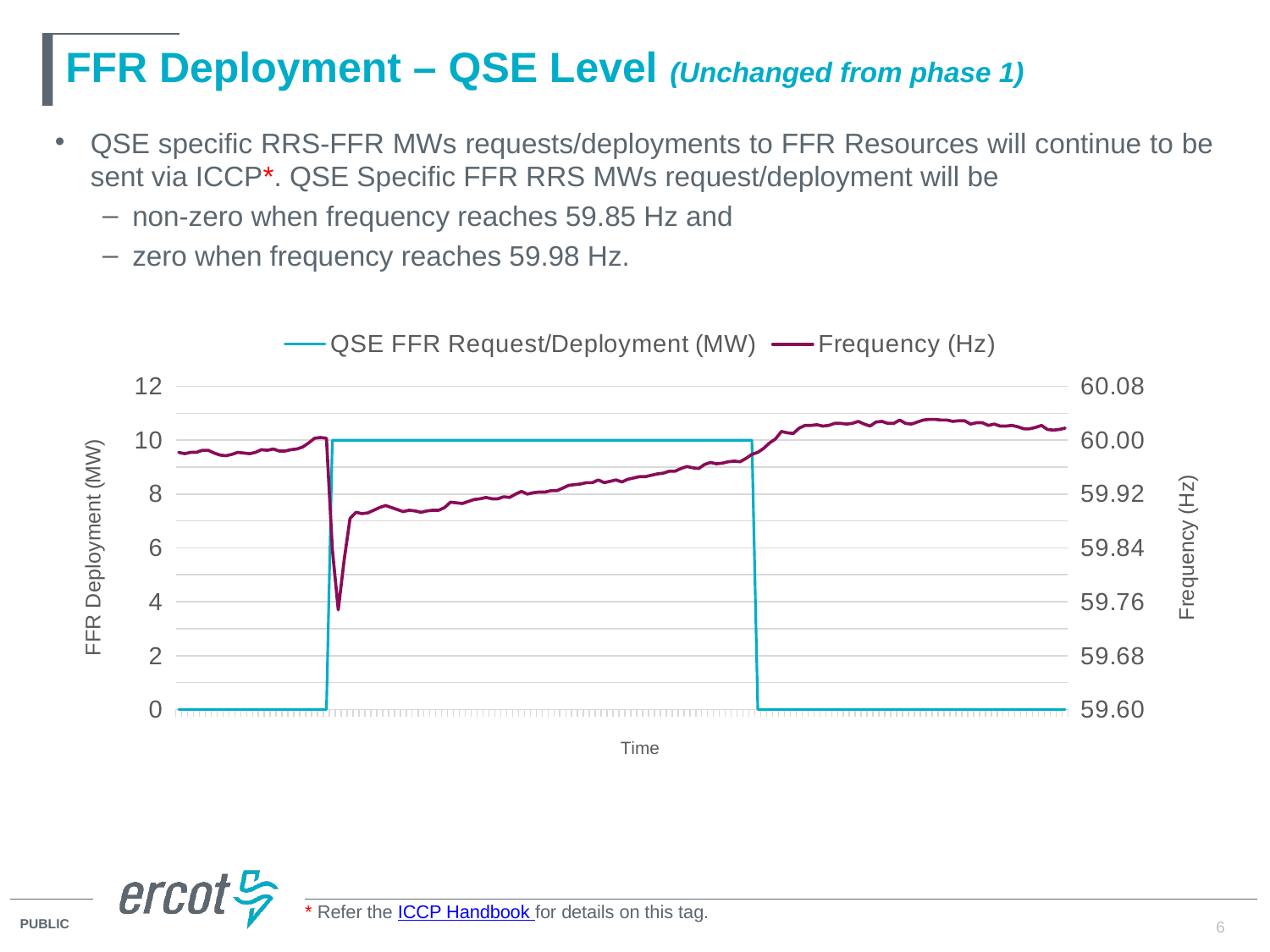
Is the Frequency (Hz) value at the end of the chart greater or less than 60.00? greater What kind of chart is shown on the slide? line chart What is the maximum value shown on the right-hand Frequency (Hz) axis? 60.08 What value does the QSE FFR Request/Deployment (MW) line hold before the deployment begins? 0 Is the Frequency (Hz) value at the start of the chart greater or less than 59.92? greater How many series does the chart legend list? 2 What is the highest value reached by the QSE FFR Request/Deployment (MW) line? 10 What are the two series named in the chart legend? QSE FFR Request/Deployment (MW) and Frequency (Hz) After its sharp dip, does the Frequency (Hz) line rise or fall over time? rise What is the title of the chart's x axis? Time What value does the QSE FFR Request/Deployment (MW) line hold while the deployment is active? 10 Is the lowest value of the Frequency (Hz) line greater or less than 59.84? less